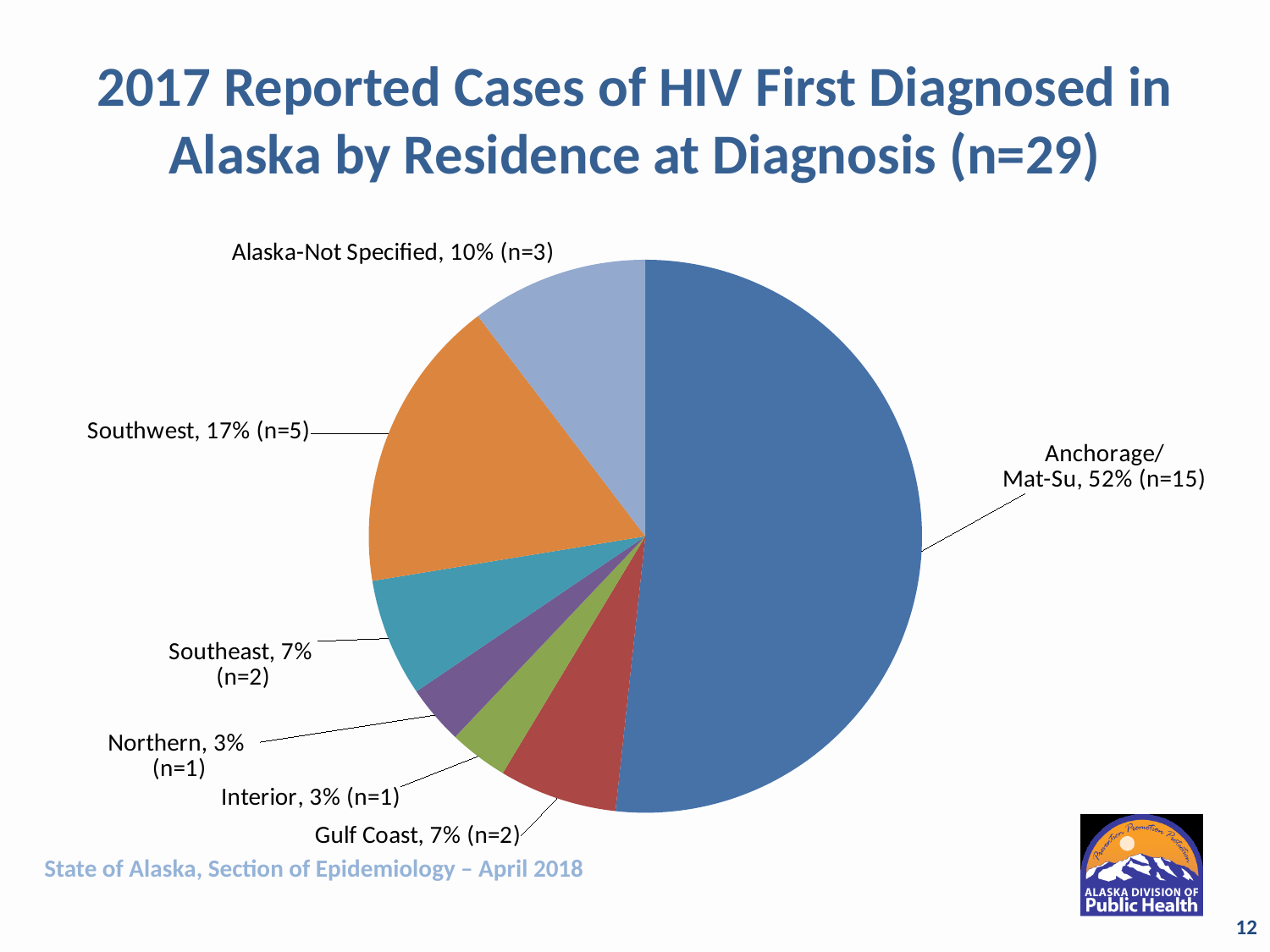
What is the total number of cases (n) given in the chart title? 29 Which has a larger share of cases, Southwest or Alaska-Not Specified? Southwest What percentage of cases is shown for Southwest? 17% What percentage of cases is shown for Alaska-Not Specified? 10% What type of chart is shown on the slide? pie chart What is the difference in percentage points between Anchorage/Mat-Su and Southwest? 35 How many regions (slices) are shown in the pie chart? 7 What share of the pie does Gulf Coast represent? 7% How many cases (n) are shown for Northern? 1 How many cases (n) are shown for Anchorage/Mat-Su? 15 Which region has the largest share of cases? Anchorage/Mat-Su What is the difference in number of cases between Southwest and Southeast? 3